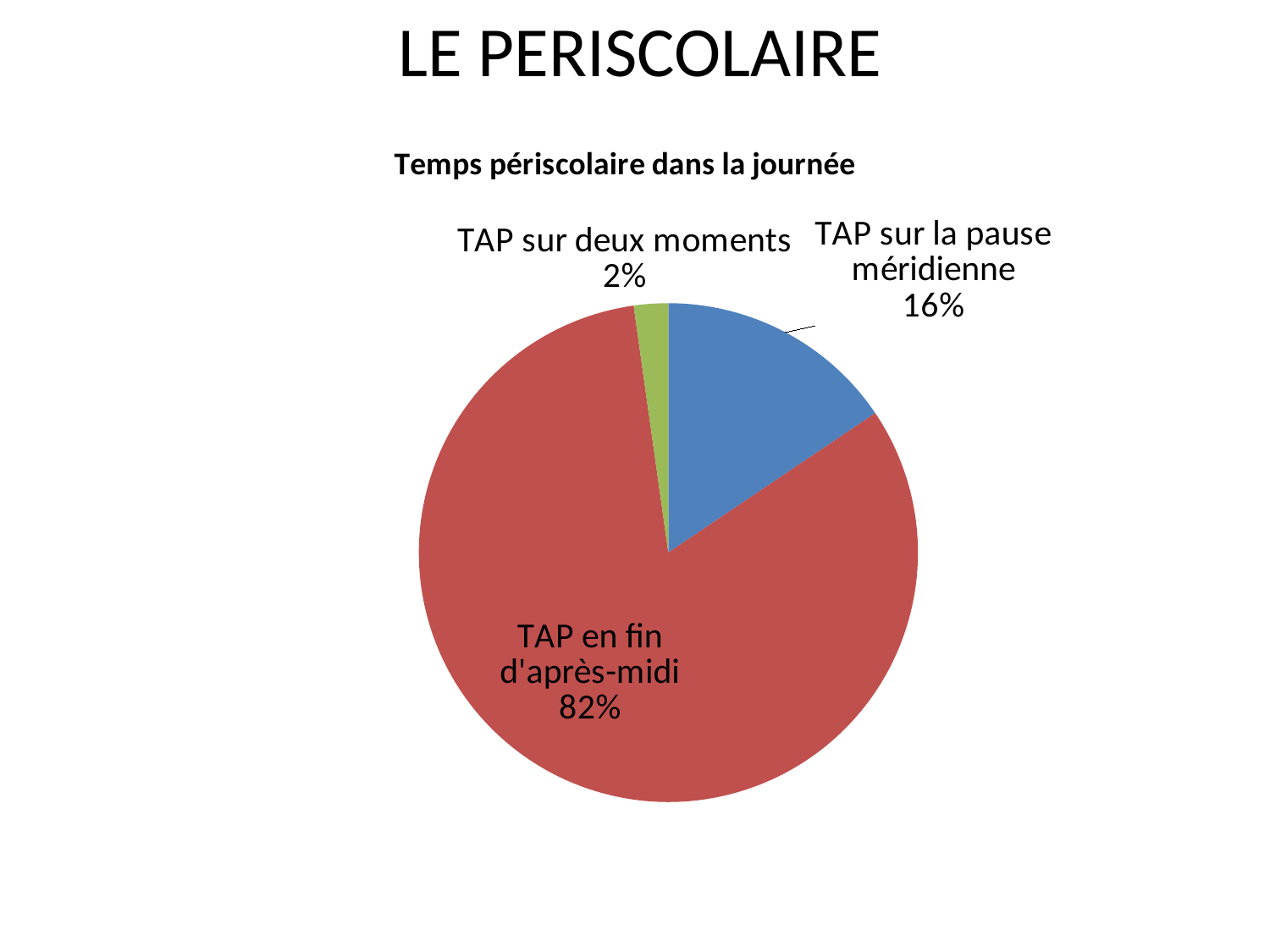
What share of the pie does "TAP sur la pause méridienne" represent? 16% What colour is the slice for "TAP sur la pause méridienne"? Blue What share of the pie does "TAP sur deux moments" represent? 2% Which category has the largest slice of the pie? TAP en fin d'après-midi What is the difference in percentage points between "TAP sur la pause méridienne" and "TAP sur deux moments"? 14 What is the title of the chart? Temps périscolaire dans la journée How many categories are shown in the pie chart? 3 Which is larger: "TAP sur la pause méridienne" or "TAP sur deux moments"? TAP sur la pause méridienne What share of the pie does "TAP en fin d'après-midi" represent? 82% Which category has the smallest slice of the pie? TAP sur deux moments What kind of chart is shown on the slide? Pie chart What is the difference in percentage points between "TAP en fin d'après-midi" and "TAP sur la pause méridienne"? 66